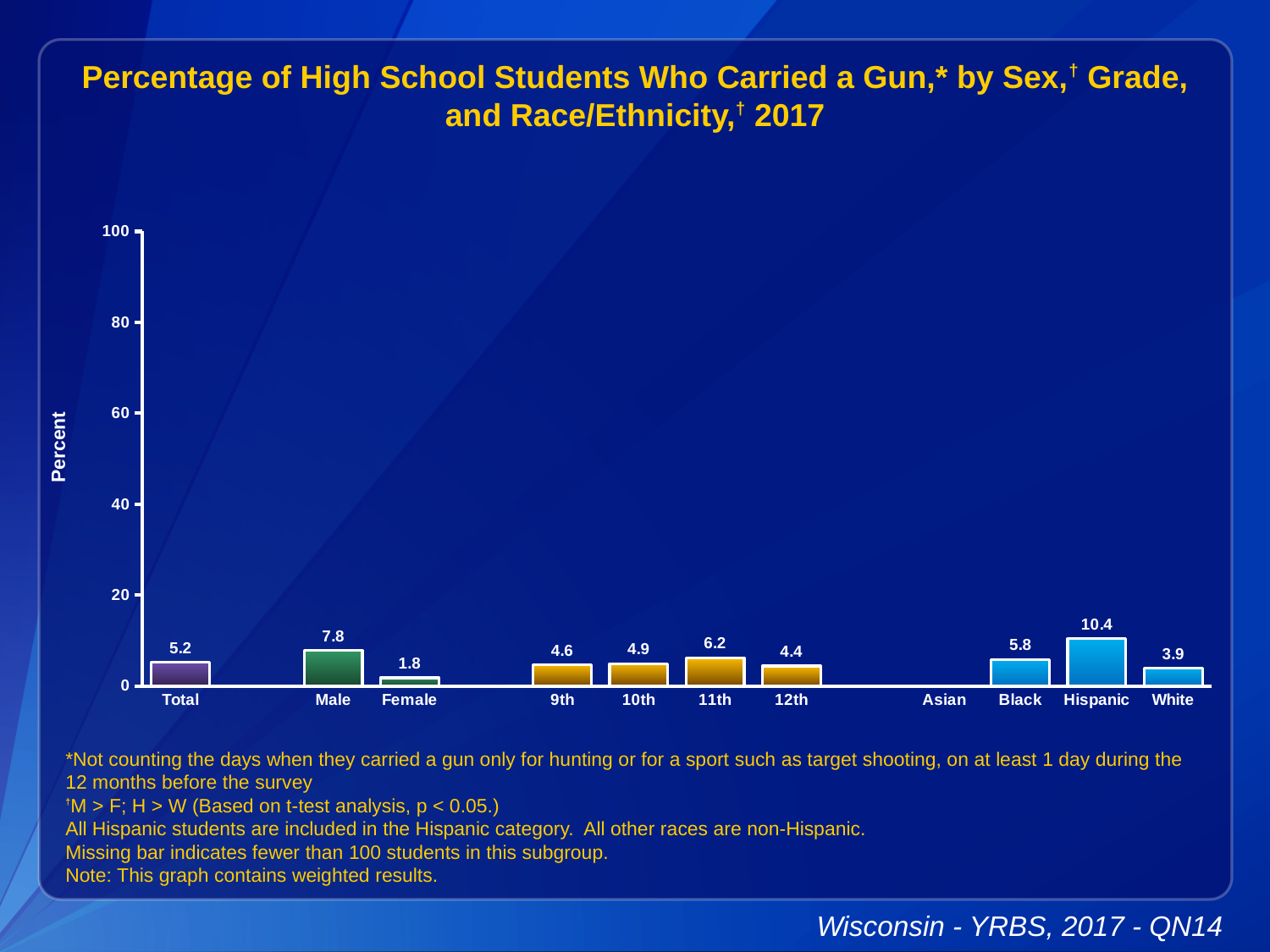
What is the label on the y axis? Percent Which category has the highest value? Hispanic Which category with a bar has the lowest value? Female Which is larger, the value for 11th grade or 12th grade? 11th Is the value for Hispanic greater or less than 20? less What is the value for Hispanic? 10.4 Which category has no bar shown? Asian How many categories have a bar plotted? 10 What kind of chart is this? bar chart What is the difference between the Male and Female values? 6.0 What is the value for Total? 5.2 What is the value for Male? 7.8